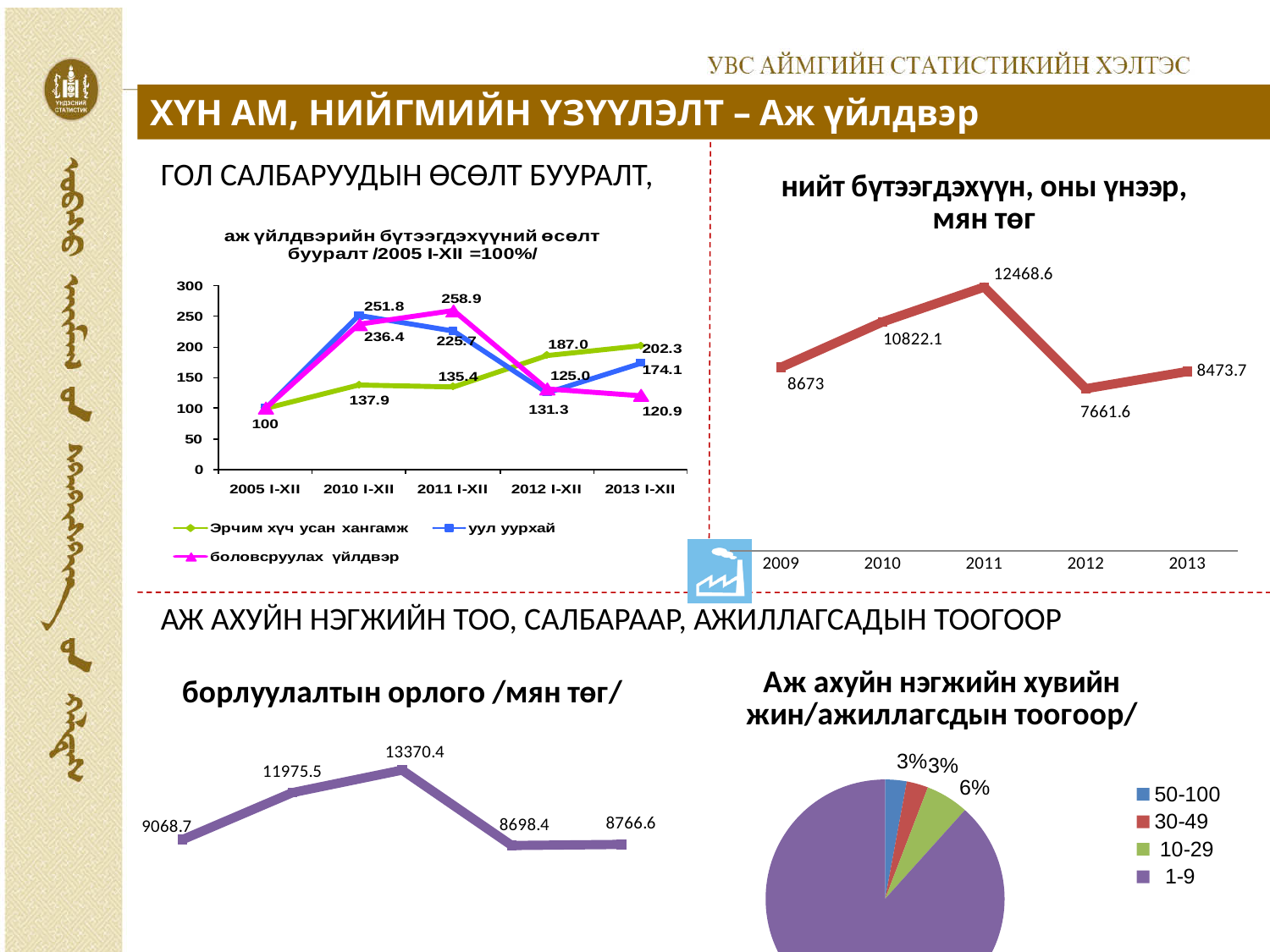
In the chart titled 'аж үйлдвэрийн бүтээгдэхүүний өсөлт бууралт /2005 I-XII =100%/', which series has the highest value at 2013 I-XII? Эрчим хүч усан хангамж In the chart titled 'нийт бүтээгдэхүүн, оны үнээр, мян төг', which year has the lowest value? 2012 In the chart titled 'аж үйлдвэрийн бүтээгдэхүүний өсөлт бууралт /2005 I-XII =100%/', what is the value of 'уул уурхай' for 2010 I-XII? 251.8 In the chart titled 'нийт бүтээгдэхүүн, оны үнээр, мян төг', what is the value for 2011? 12468.6 In the chart titled 'аж үйлдвэрийн бүтээгдэхүүний өсөлт бууралт /2005 I-XII =100%/', which is larger at 2011 I-XII: 'уул уурхай' or 'боловсруулах үйлдвэр'? боловсруулах үйлдвэр In the chart titled 'аж үйлдвэрийн бүтээгдэхүүний өсөлт бууралт /2005 I-XII =100%/', what is the value of 'боловсруулах үйлдвэр' for 2013 I-XII? 120.9 In the pie chart titled 'Аж ахуйн нэгжийн хувийн жин/ажиллагсдын тоогоор/', what share does the '10-29' slice have? 6% In the chart titled 'аж үйлдвэрийн бүтээгдэхүүний өсөлт бууралт /2005 I-XII =100%/', how many series does the legend list? 3 In the chart titled 'нийт бүтээгдэхүүн, оны үнээр, мян төг', what is the difference between the 2011 and 2012 values? 4807 In the pie chart titled 'Аж ахуйн нэгжийн хувийн жин/ажиллагсдын тоогоор/', how many categories does the legend list? 4 In the chart titled 'борлуулалтын орлого /мян төг/', what is the highest value shown? 13370.4 What kind of chart is the one titled 'борлуулалтын орлого /мян төг/'? line chart